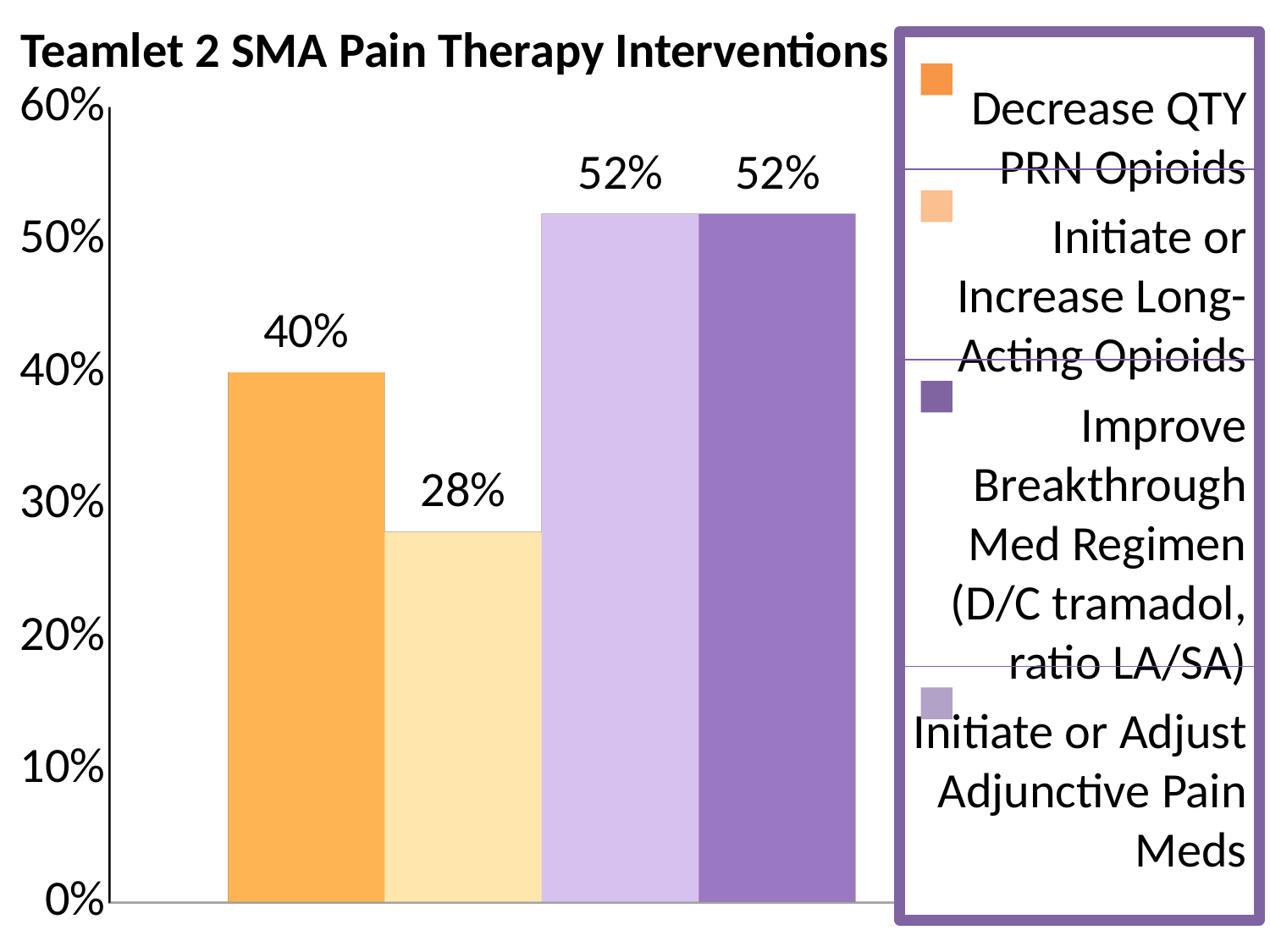
What is the highest value shown on the chart? 52% What is the value for Improve Breakthrough Med Regimen (D/C tramadol, ratio LA/SA)? 52% Which is larger, the value for Improve Breakthrough Med Regimen or the value for Decrease QTY PRN Opioids? Improve Breakthrough Med Regimen Which intervention has the lowest value? Initiate or Increase Long-Acting Opioids What is the value for Initiate or Increase Long-Acting Opioids? 28% What is the value for Initiate or Adjust Adjunctive Pain Meds? 52% Is the value for Initiate or Increase Long-Acting Opioids greater or less than 30%? less What is the value for Decrease QTY PRN Opioids? 40% What is the title of the chart? Teamlet 2 SMA Pain Therapy Interventions What kind of chart is shown? bar chart How many bars are plotted on the chart? 4 What is the difference between the values for Decrease QTY PRN Opioids and Initiate or Increase Long-Acting Opioids? 12%